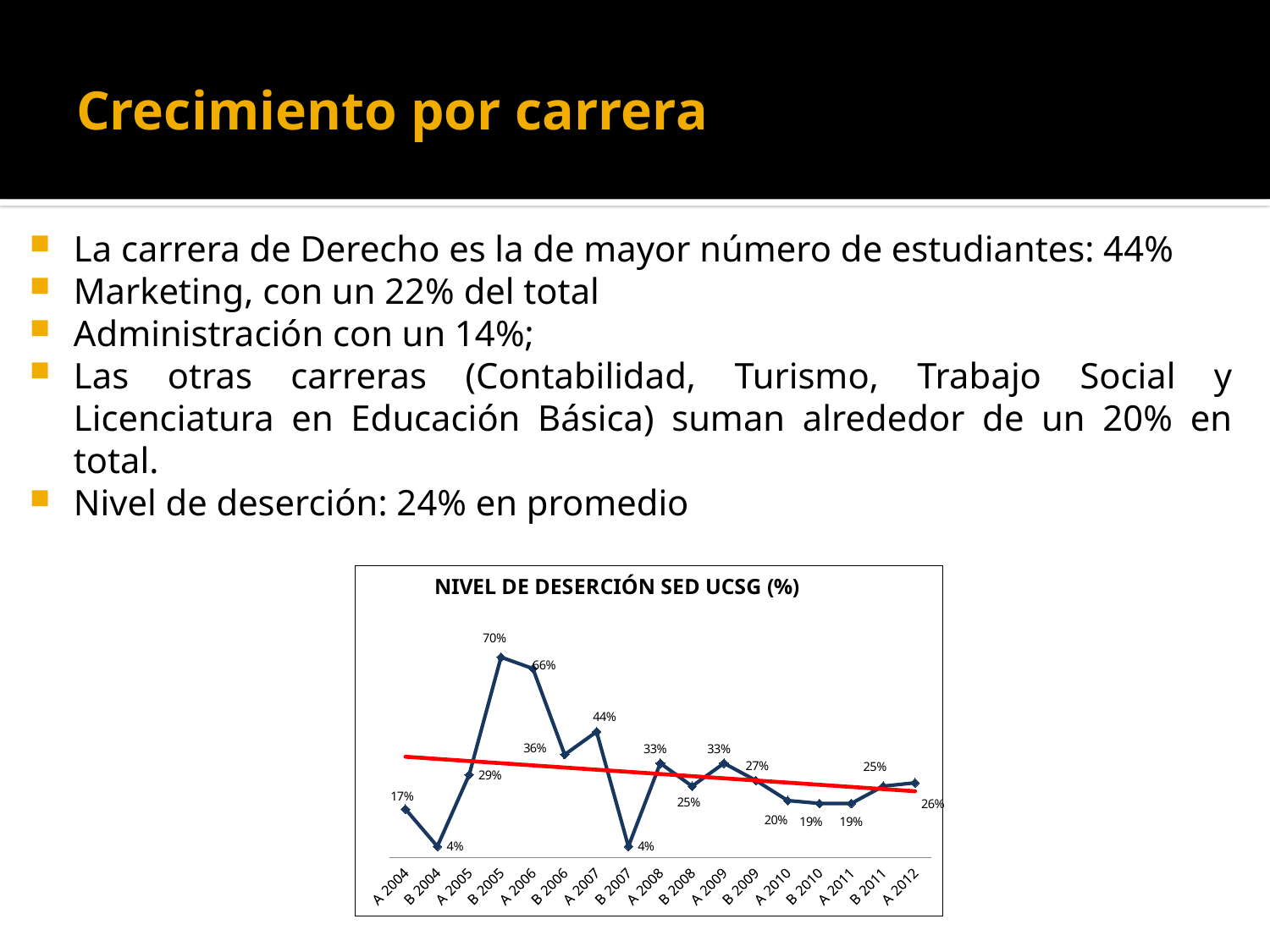
How many data points are plotted in the chart? 17 What is the value for A 2007 in the chart? 44% What is the value for A 2004 in the chart? 17% What is the difference between the values for B 2005 and A 2006? 4% Does the red trend line in the chart rise or fall from left to right? fall Which period has the highest value in the chart? B 2005 What is the title of the chart on the slide? NIVEL DE DESERCIÓN SED UCSG (%) Which is larger, the value for A 2008 or the value for B 2008? A 2008 What is the value for A 2012 in the chart? 26% What is the value for B 2005 in the chart? 70% What is the lowest value shown in the chart? 4% What kind of chart is shown on the slide? line chart